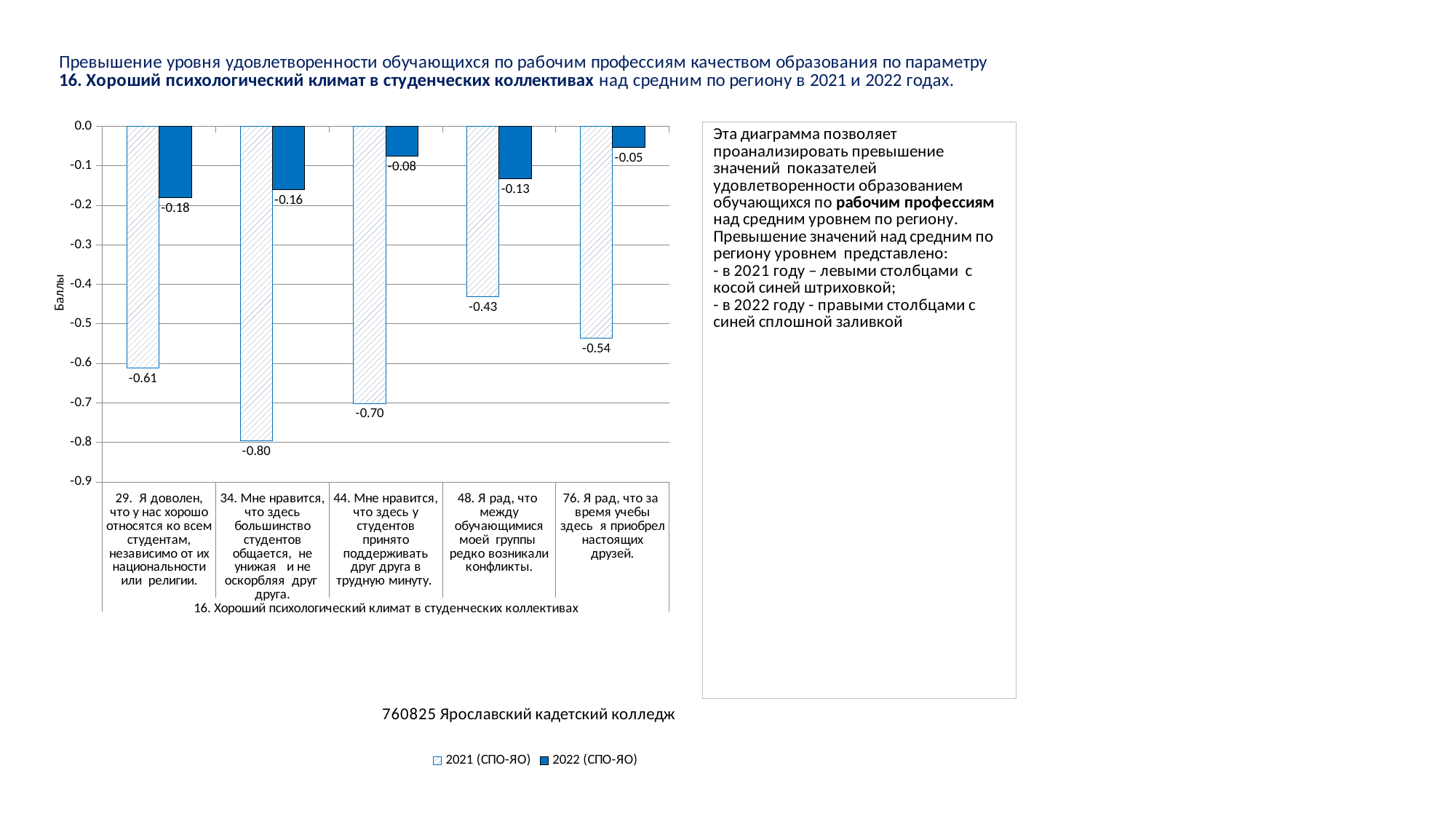
Which category has the lowest 2022 (СПО-ЯО) value? 29. Я доволен, что у нас хорошо относятся ко всем студентам, независимо от их национальности или религии. How many categories are shown on the x axis of the chart? 5 How many series does the legend list? 2 What is the 2022 (СПО-ЯО) value for category 44 (Мне нравится, что здесь у студентов принято поддерживать друг друга...)? -0.08 For category 48, which is larger: the 2021 (СПО-ЯО) value or the 2022 (СПО-ЯО) value? 2022 (СПО-ЯО) What is the difference between the 2021 and 2022 values for category 34? 0.64 Which category has the highest 2022 (СПО-ЯО) value? 76. Я рад, что за время учебы здесь я приобрел настоящих друзей. What is the label of the vertical axis? Баллы Which category has the lowest 2021 (СПО-ЯО) value? 34. Мне нравится, что здесь большинство студентов общается, не унижая и не оскорбляя друг друга. What is the 2021 (СПО-ЯО) value for category 29 (Я доволен, что у нас хорошо относятся ко всем студентам...)? -0.61 What kind of chart is shown on the slide? Bar chart What is the 2021 (СПО-ЯО) value for category 76 (Я рад, что за время учебы здесь я приобрел настоящих друзей)? -0.54